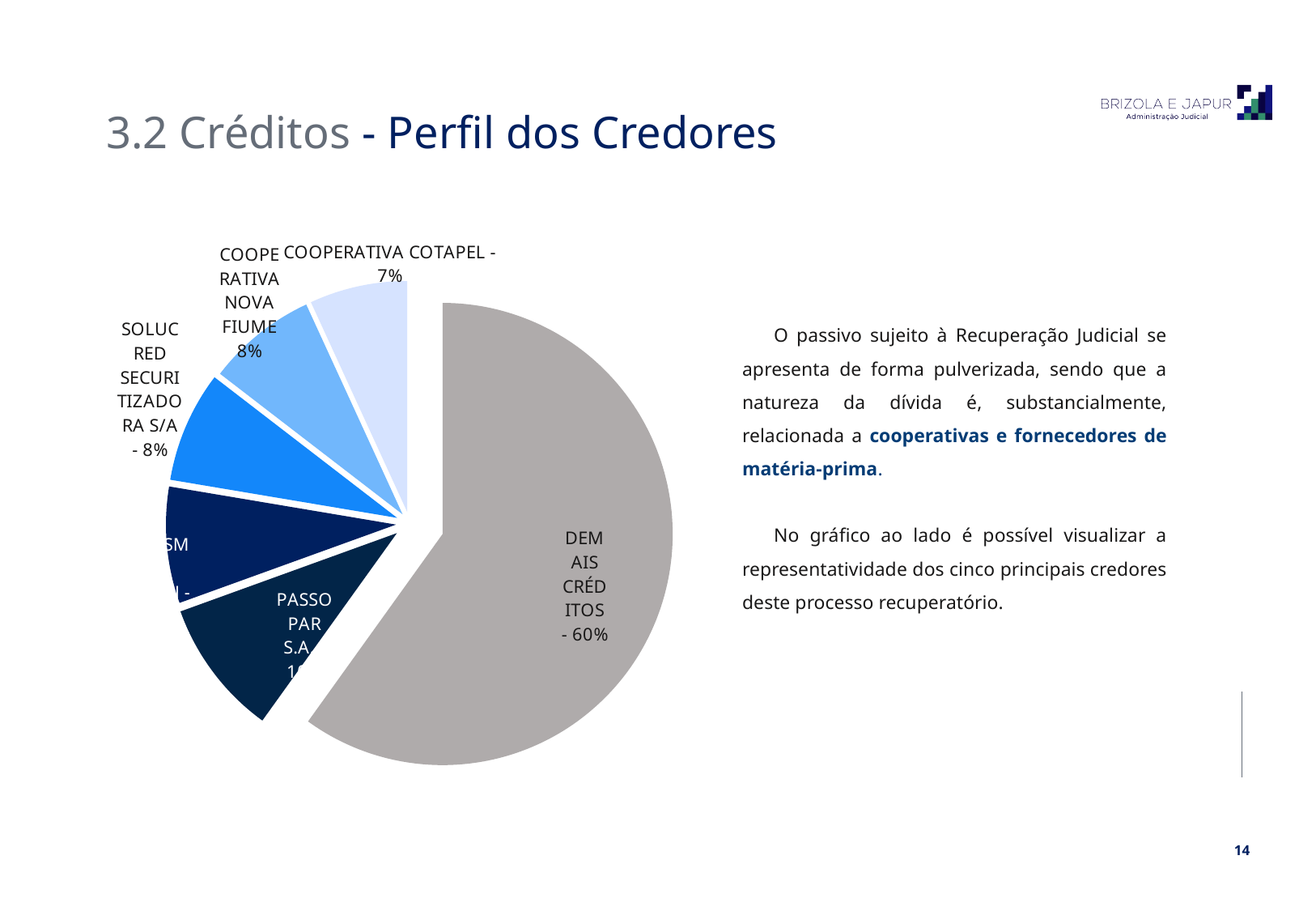
What percentage is shown for COOPERATIVA COTAPEL? 7% What percentage is shown for SOLUCRED SECURITIZADORA S/A? 8% What colour is the DEMAIS CRÉDITOS slice? Grey What is the difference in percentage points between COOPERATIVA NOVA FIUME and COOPERATIVA COTAPEL? 1 percentage point What kind of chart is shown on the slide? Pie chart Do COOPERATIVA NOVA FIUME and SOLUCRED SECURITIZADORA S/A have the same share of the pie? Yes, both 8% How many slices does the pie chart have? 6 What is the difference in percentage points between DEMAIS CRÉDITOS and COOPERATIVA COTAPEL? 53 percentage points What percentage is shown for COOPERATIVA NOVA FIUME? 8% What share of the pie does DEMAIS CRÉDITOS represent? 60% Which is larger, the slice for DEMAIS CRÉDITOS or the slice for COOPERATIVA COTAPEL? DEMAIS CRÉDITOS Which slice of the pie chart is the largest? DEMAIS CRÉDITOS